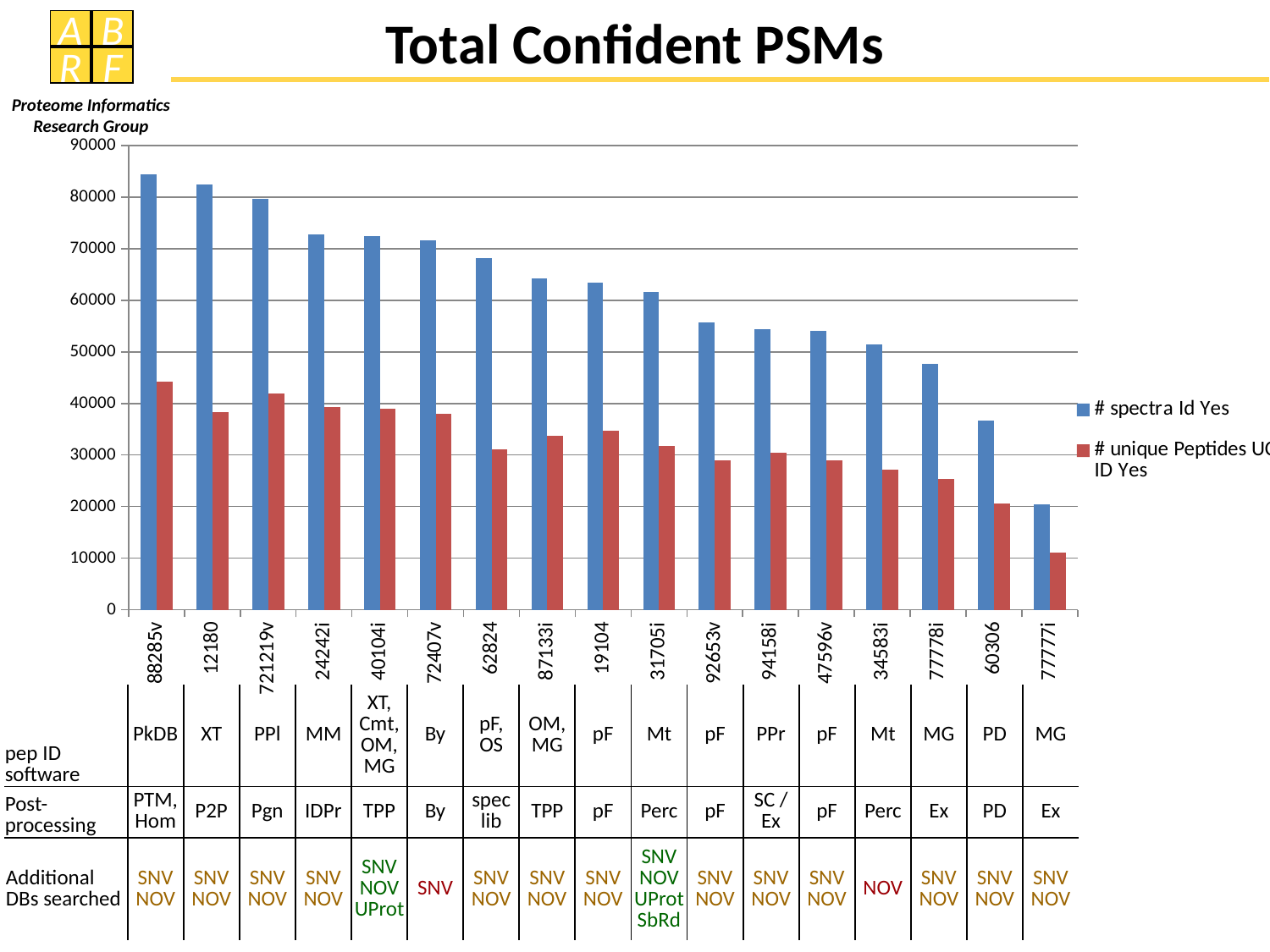
How many series does the legend list? 2 How many categories are plotted along the x axis? 17 Is the # spectra Id Yes value for 77778i greater or less than 50000? less What kind of chart is shown on the slide? bar chart Which category has the lowest value for # spectra Id Yes? 77777i Which category has the highest value for # spectra Id Yes? 88285v Is the # unique Peptides value for 88285v greater or less than 40000? greater Which category has the lowest value for the # unique Peptides series? 77777i Is the # spectra Id Yes value for 88285v greater or less than 80000? greater Which has the larger # spectra Id Yes value, 24242i or 62824? 24242i Do the # spectra Id Yes values generally rise or fall from left to right along the x axis? fall